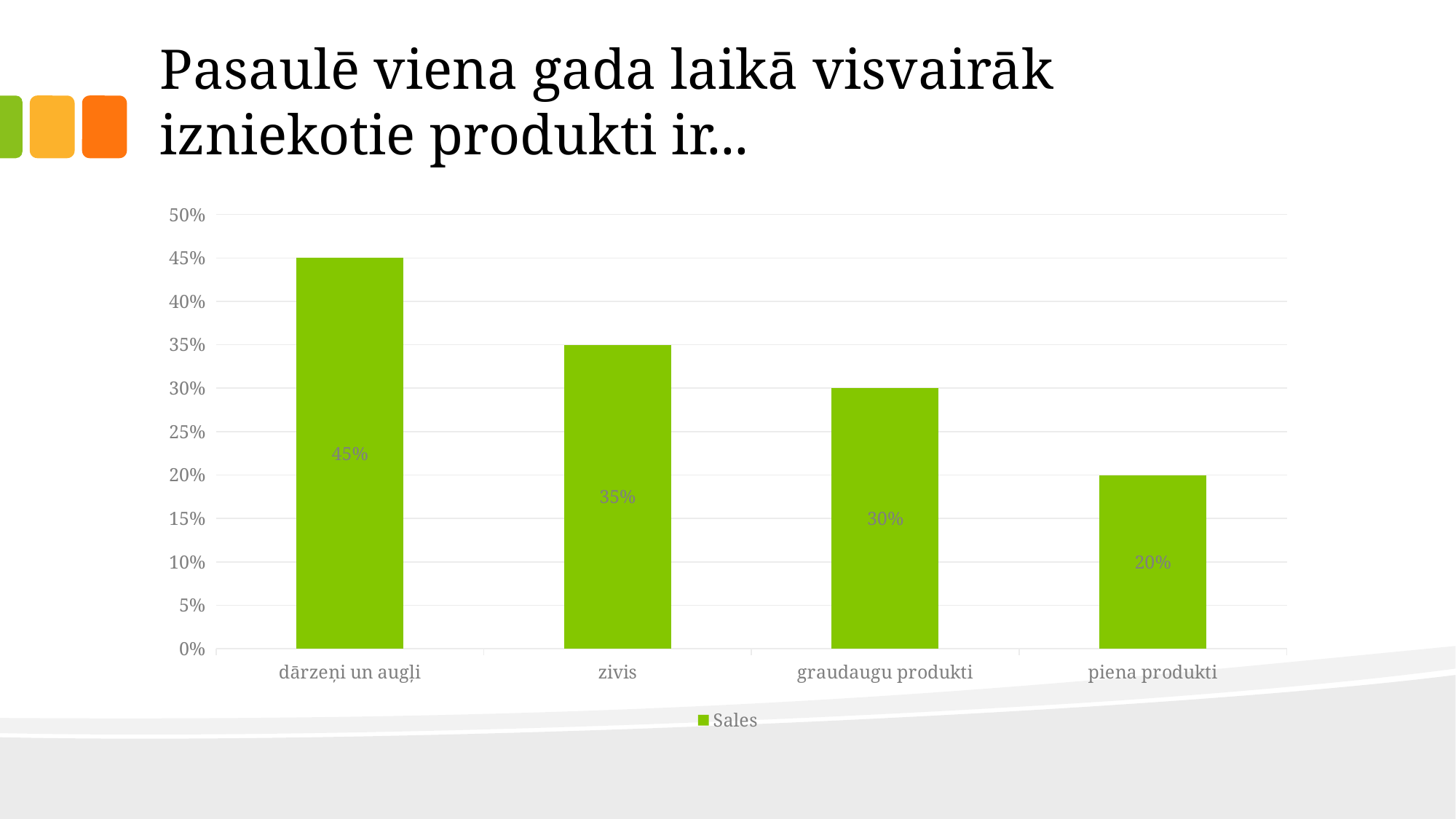
How many categories are shown on the x axis? 4 What kind of chart is shown on the slide? bar chart Do the values rise or fall from left to right along the x axis? fall What is the difference between the values for dārzeņi un augļi and piena produkti? 25% What is the value for piena produkti? 20% Which category has the lowest value? piena produkti What is the value for graudaugu produkti? 30% Which is larger, the value for zivis or the value for graudaugu produkti? zivis What is the value for dārzeņi un augļi? 45% What is the value for zivis? 35% Which category has the highest value? dārzeņi un augļi Is the value for graudaugu produkti greater or less than 40%? less